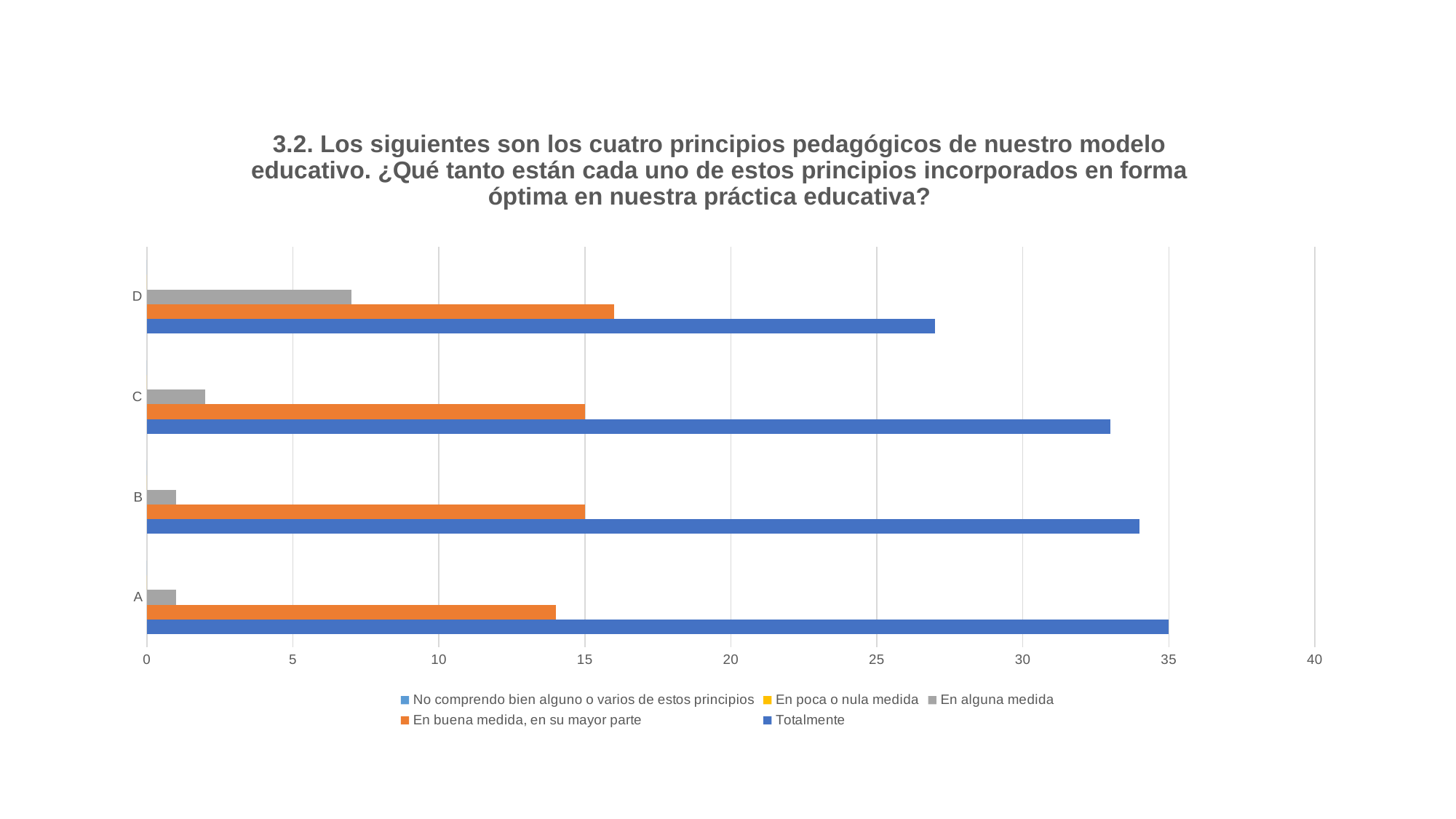
How many categories are shown on the vertical axis of the chart? 4 What kind of chart is shown on the slide? bar chart Which category has the highest value for the 'En alguna medida' series? D Is the 'Totalmente' value for category D greater or less than 25? greater Which category has the lowest value for the 'Totalmente' series? D Is the 'En alguna medida' value for category D greater or less than 10? less What is the value of the 'En buena medida, en su mayor parte' series for category C? 15 How many series does the chart's legend list? 5 For category C, which series has the larger value: 'Totalmente' or 'En buena medida, en su mayor parte'? Totalmente What is the value of the 'En buena medida, en su mayor parte' series for category B? 15 What is the value of the 'Totalmente' series for category A? 35 Which series is shown in orange in the chart's legend? En buena medida, en su mayor parte